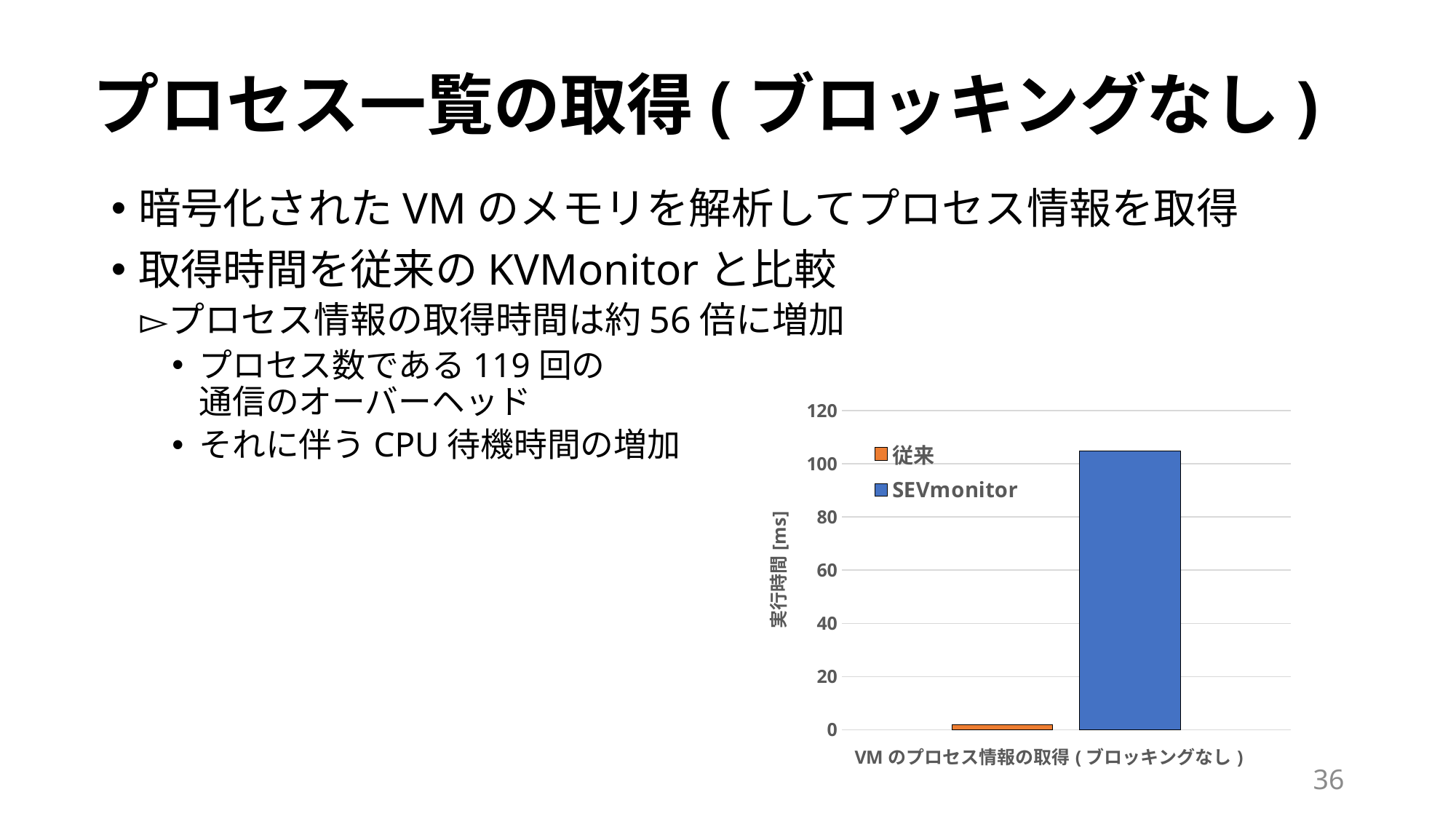
Is the value for 従来 greater or less than 20? less What kind of chart is shown on the slide? bar chart Which series has the higher bar in the chart, 従来 or SEVmonitor? SEVmonitor What colour is the bar for SEVmonitor in the chart? blue Which series has the lowest bar in the chart? 従来 How many categories are plotted on the x axis of the chart? 1 How many series does the chart legend list? 2 Is the value for SEVmonitor greater or less than 120? less Which series has the highest bar in the chart? SEVmonitor Is the value for SEVmonitor greater or less than 100? greater What is the label of the y axis of the chart? 実行時間 [ms]